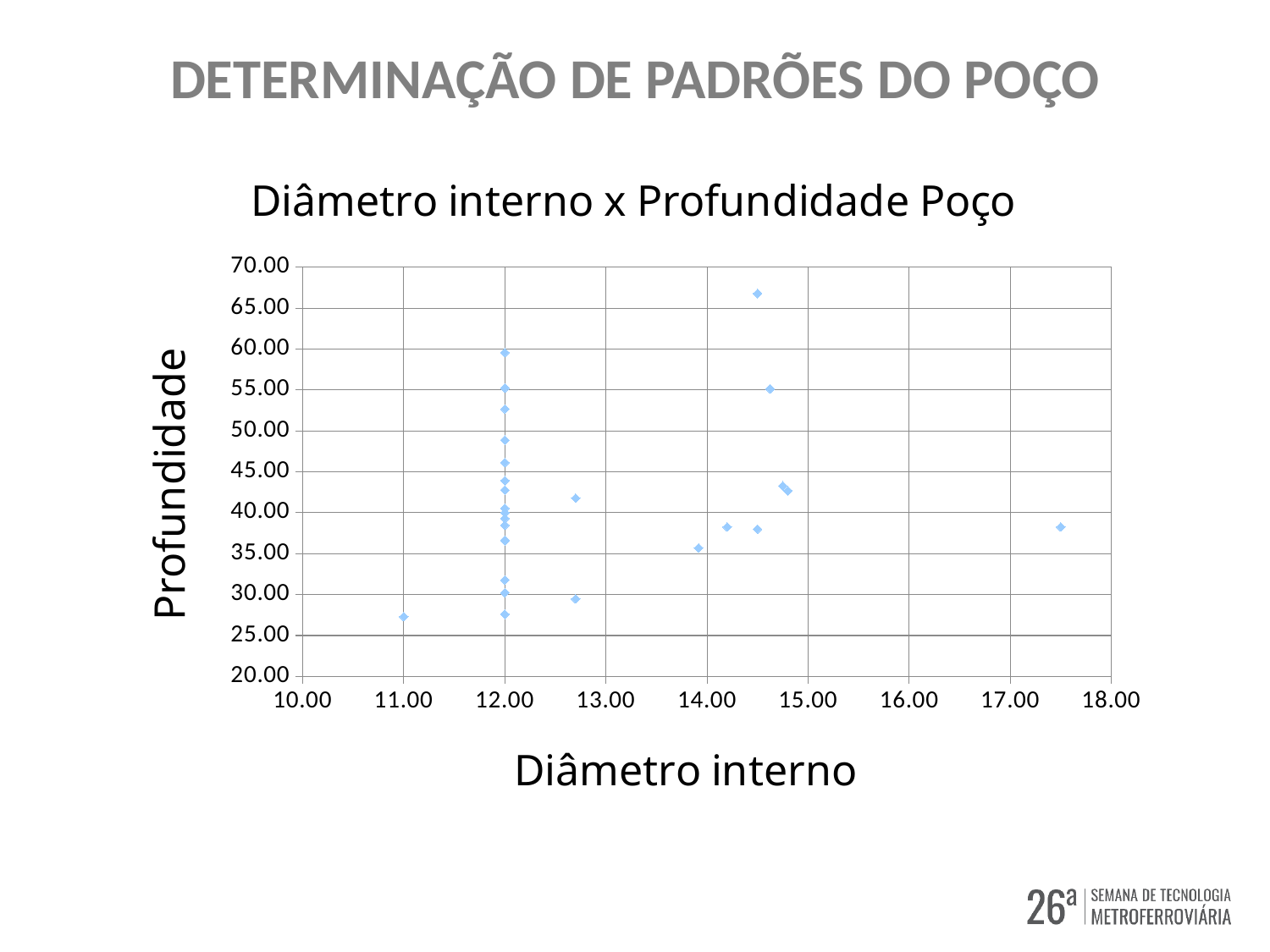
Is the Profundidade of the point at Diâmetro interno 17.50 greater or less than 40.00? less What is the title of the chart? Diâmetro interno x Profundidade Poço Is the Profundidade of the highest point on the chart greater or less than 65.00? greater Which has the higher Profundidade: the point at Diâmetro interno 11.00 or the point at Diâmetro interno 17.50? The point at 17.50 Which has the higher Profundidade: the highest point near Diâmetro interno 14.50 or the highest point at Diâmetro interno 12.00? The point near 14.50 Is the Profundidade of the upper point at Diâmetro interno 12.70 greater or less than 40.00? greater What kind of chart is shown on the slide? Scatter chart What is the label of the vertical axis of the chart? Profundidade